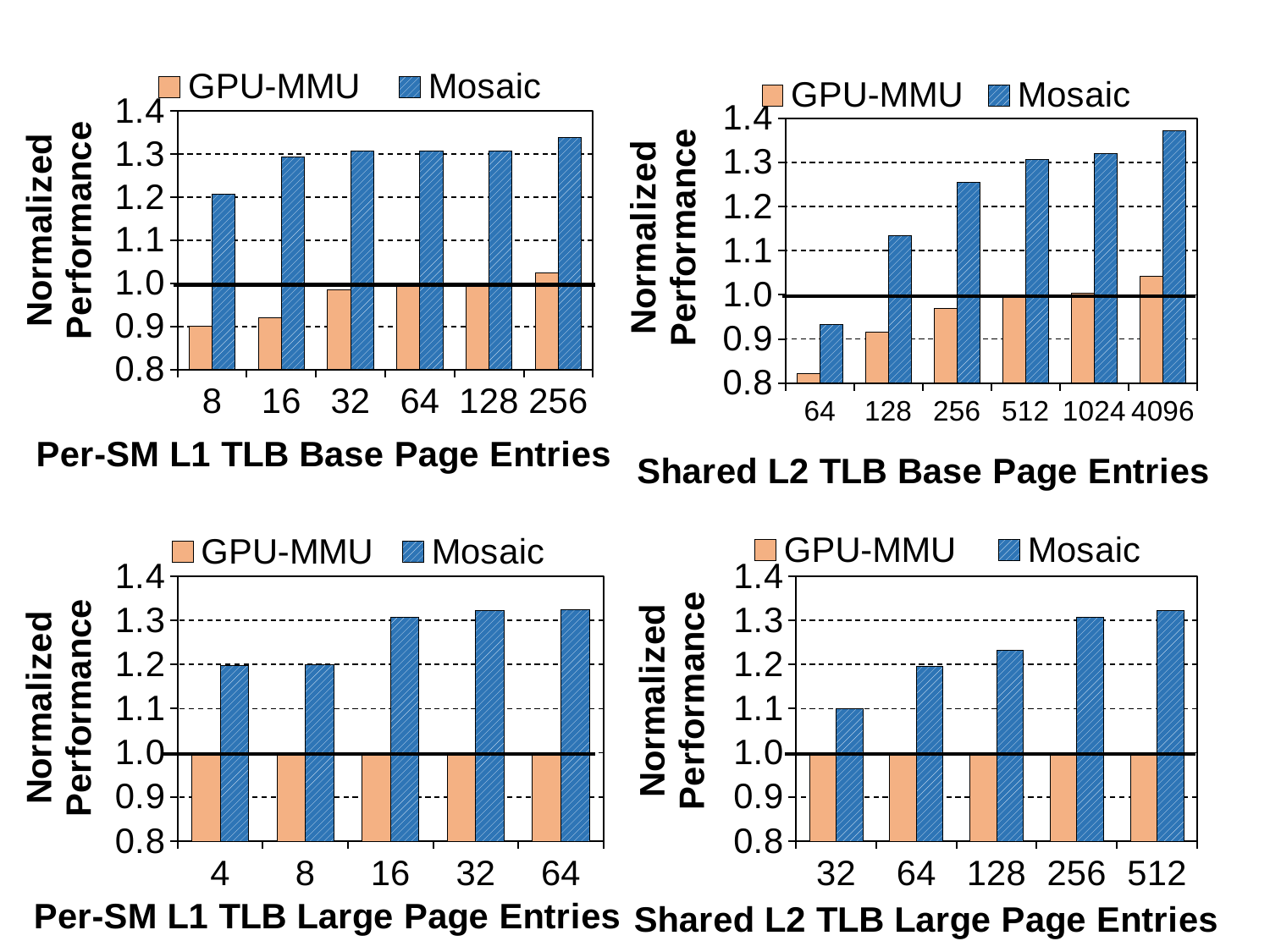
In the Shared L2 TLB Large Page Entries chart, which is larger for Mosaic: the value at 32 entries or at 512 entries? 512 entries In the Shared L2 TLB Large Page Entries chart, which category has the lowest Mosaic value? 32 In the Per-SM L1 TLB Base Page Entries chart, is the GPU-MMU value at 8 entries greater or less than 1.0? less In the Per-SM L1 TLB Large Page Entries chart, how many categories are shown on the x axis? 5 In the Shared L2 TLB Base Page Entries chart, which category has the highest Mosaic value? 4096 In the Shared L2 TLB Large Page Entries chart, do the Mosaic values rise or fall as the number of entries increases along the x axis? rise In the Per-SM L1 TLB Base Page Entries chart, how many series does the legend list? 2 In the Shared L2 TLB Base Page Entries chart, is the Mosaic value at 64 entries greater or less than 1.0? less In the Per-SM L1 TLB Base Page Entries chart, how many categories are shown on the x axis? 6 In the Shared L2 TLB Base Page Entries chart, is the Mosaic value at 4096 entries greater or less than 1.3? greater What kind of chart is the Per-SM L1 TLB Base Page Entries chart? bar chart